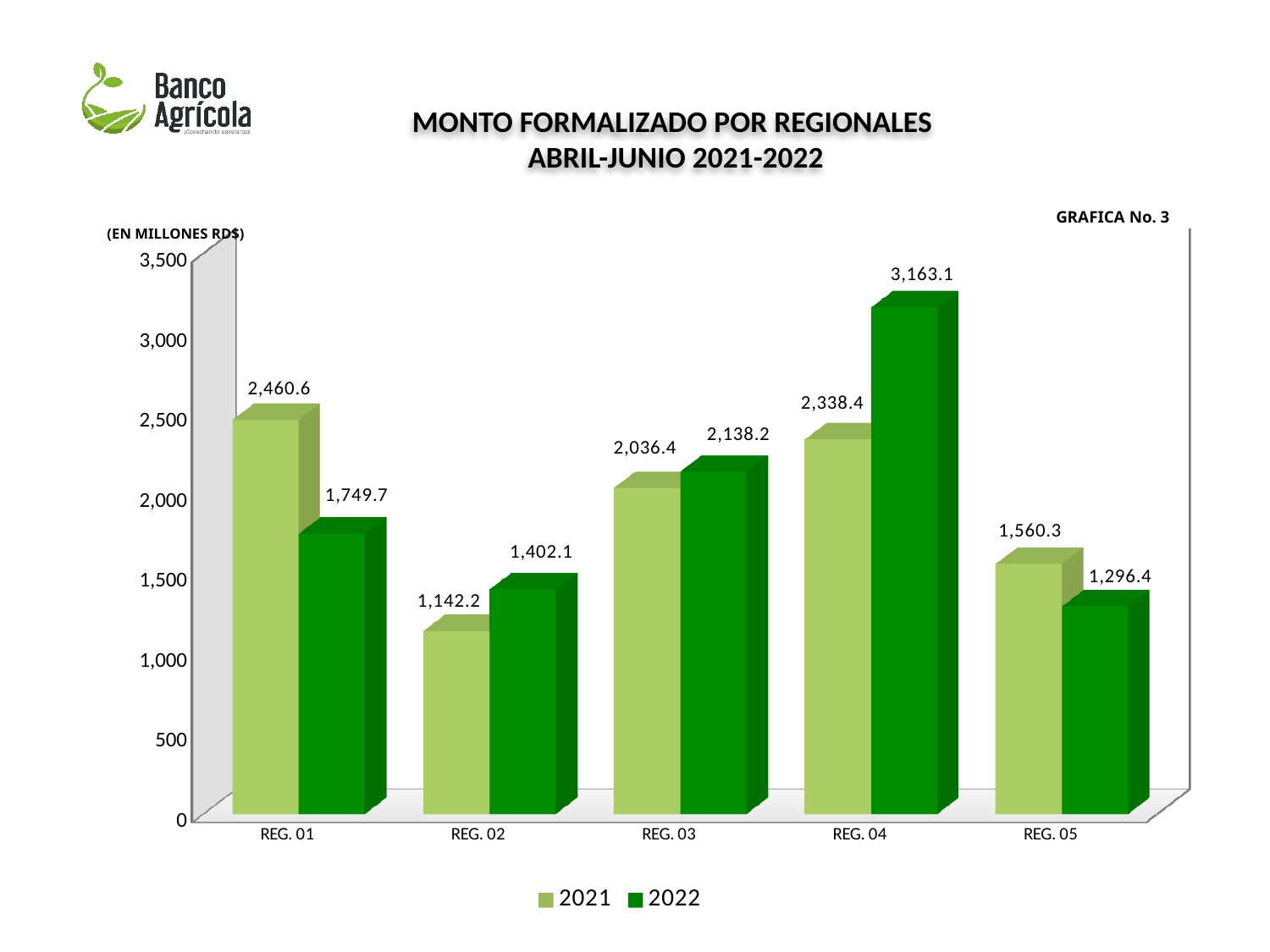
What is the difference between the 2021 and 2022 values for REG. 01? 710.9 For REG. 03, which series has the larger value, 2021 or 2022? 2022 Is the 2021 value for REG. 05 greater or less than 1,500? greater What is the value for REG. 02 in the 2021 series? 1,142.2 Which region has the lowest value in the 2021 series? REG. 02 What is the difference between the 2022 and 2021 values for REG. 04? 824.7 What is the value for REG. 05 in the 2022 series? 1,296.4 Which region has the highest value in the 2022 series? REG. 04 How many regions are shown on the x axis? 5 What kind of chart is shown on the slide? Bar chart What is the value for REG. 04 in the 2022 series? 3,163.1 How many series does the legend list? 2